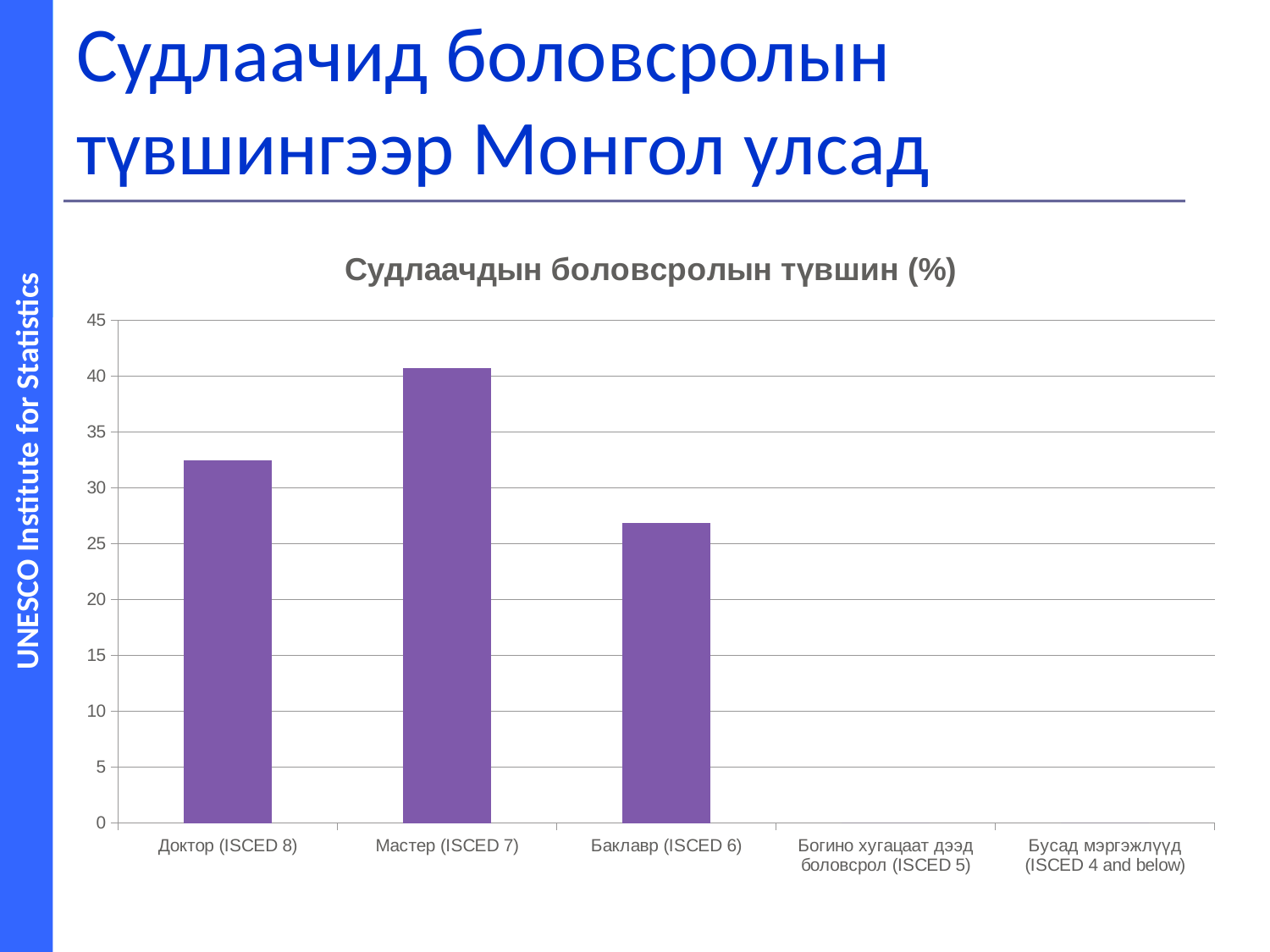
Which is larger, the value for Доктор (ISCED 8) or the value for Мастер (ISCED 7)? Мастер (ISCED 7) How many categories have a visible bar in the chart? 3 What is the title of the chart? Судлаачдын боловсролын түвшин (%) Which category has the highest value in the chart? Мастер (ISCED 7) Which of the three visible bars is the shortest? Баклавр (ISCED 6) How many categories are shown on the x axis of the chart? 5 Is the value for Баклавр (ISCED 6) greater or less than 30? less Is the value for Доктор (ISCED 8) greater or less than 30? greater Which is larger, the value for Доктор (ISCED 8) or the value for Баклавр (ISCED 6)? Доктор (ISCED 8) What colour are the bars in the chart? purple Is the value for Мастер (ISCED 7) greater or less than 35? greater What kind of chart is shown on the slide? bar chart